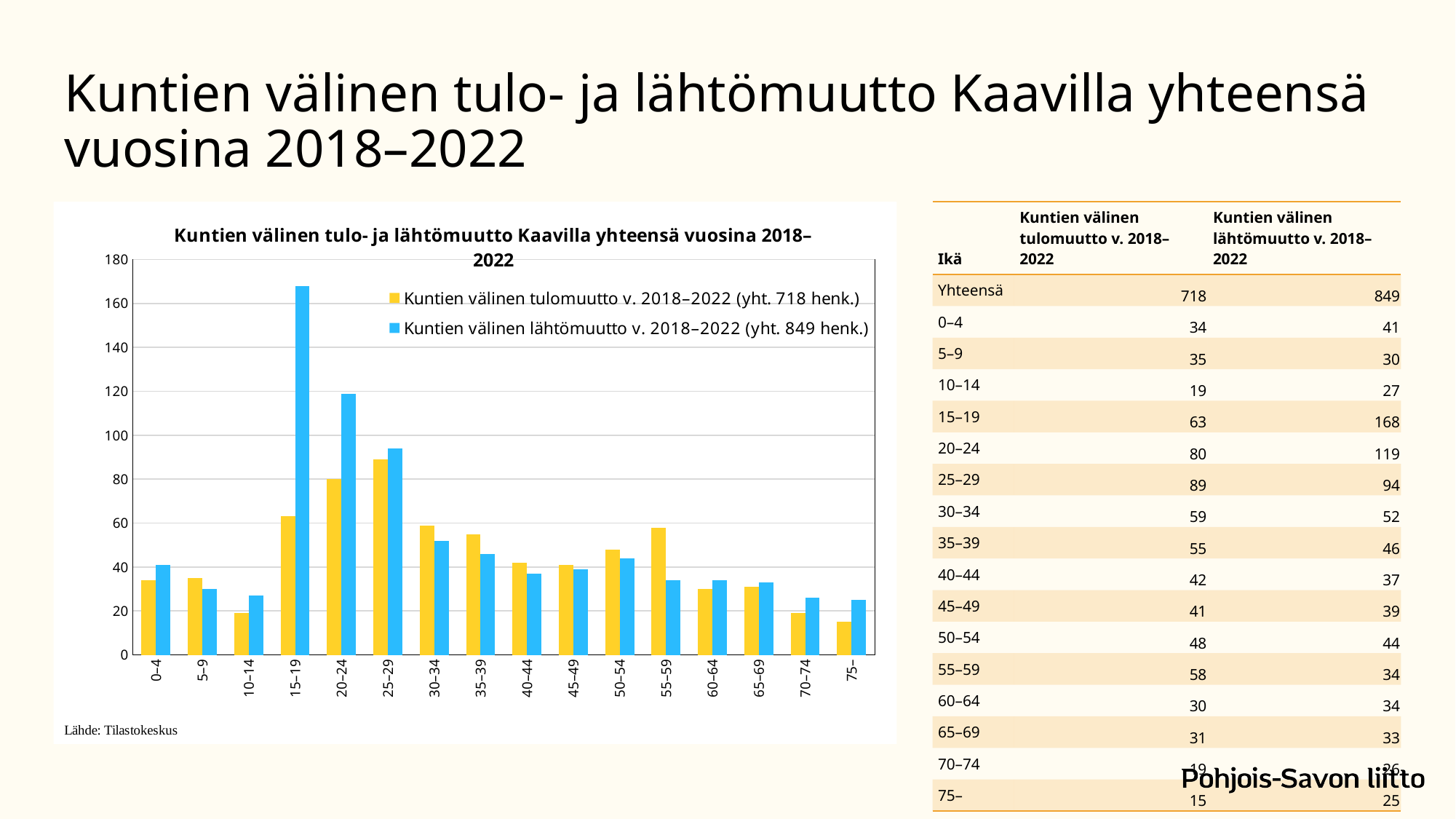
For the 55–59 age group, which is larger: tulomuutto or lähtömuutto? tulomuutto For the 25–29 age group, which is larger: tulomuutto or lähtömuutto? lähtömuutto According to the legend, what is the total number of persons for Kuntien välinen tulomuutto v. 2018–2022? 718 henk. How many age groups are shown on the x axis of the chart? 16 Which age group has the lowest value for Kuntien välinen tulomuutto v. 2018–2022? 75– What is the value of Kuntien välinen tulomuutto v. 2018–2022 for the 20–24 age group? 80 What kind of chart is shown on the slide? bar chart Which age group has the highest value for Kuntien välinen lähtömuutto v. 2018–2022? 15–19 What is the difference between lähtömuutto and tulomuutto for the 15–19 age group? 105 Is the value for Kuntien välinen lähtömuutto in the 20–24 age group greater or less than 100? greater How many series does the chart legend list? 2 What is the value of Kuntien välinen lähtömuutto v. 2018–2022 for the 15–19 age group? 168